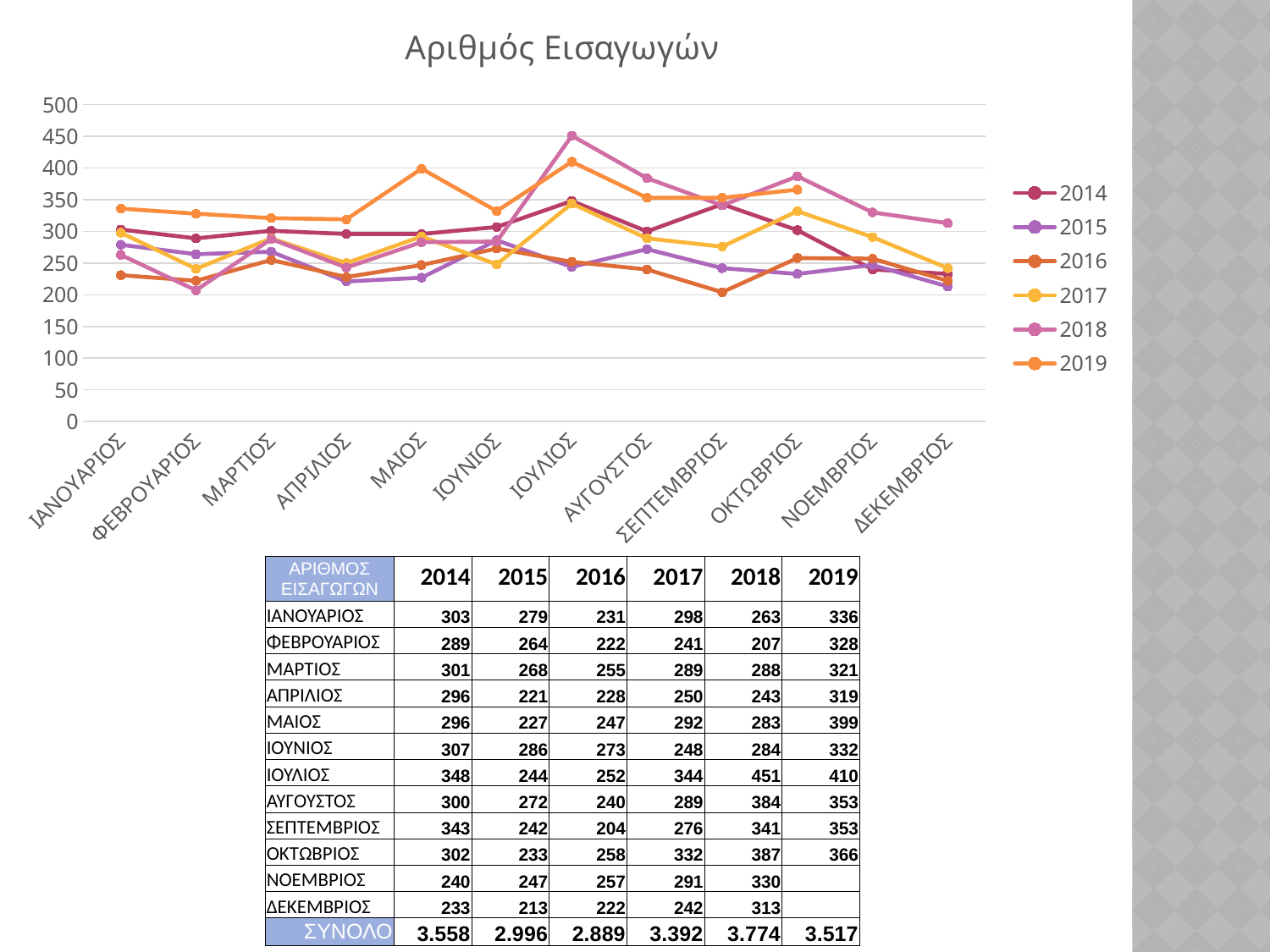
How many categories (months) are plotted along the x axis? 12 What kind of chart is shown on the slide? line chart Is the value for 2018 in ΙΟΥΛΙΟΣ greater or less than 400? greater What is the title of the chart? Αριθμός Εισαγωγών Does the 2019 series rise or fall from ΙΑΝΟΥΑΡΙΟΣ to ΑΠΡΙΛΙΟΣ? fall What is the difference between the 2018 and 2019 values in ΙΟΥΛΙΟΣ? 41 What is the value for 2019 in ΜΑΙΟΣ? 399 Which month has the lowest value for the 2019 series? ΑΠΡΙΛΙΟΣ How many series does the legend list? 6 Which month has the highest value for the 2018 series? ΙΟΥΛΙΟΣ Which is larger in ΙΑΝΟΥΑΡΙΟΣ, the value for 2014 or the value for 2019? 2019 What is the value for 2018 in ΙΟΥΛΙΟΣ? 451